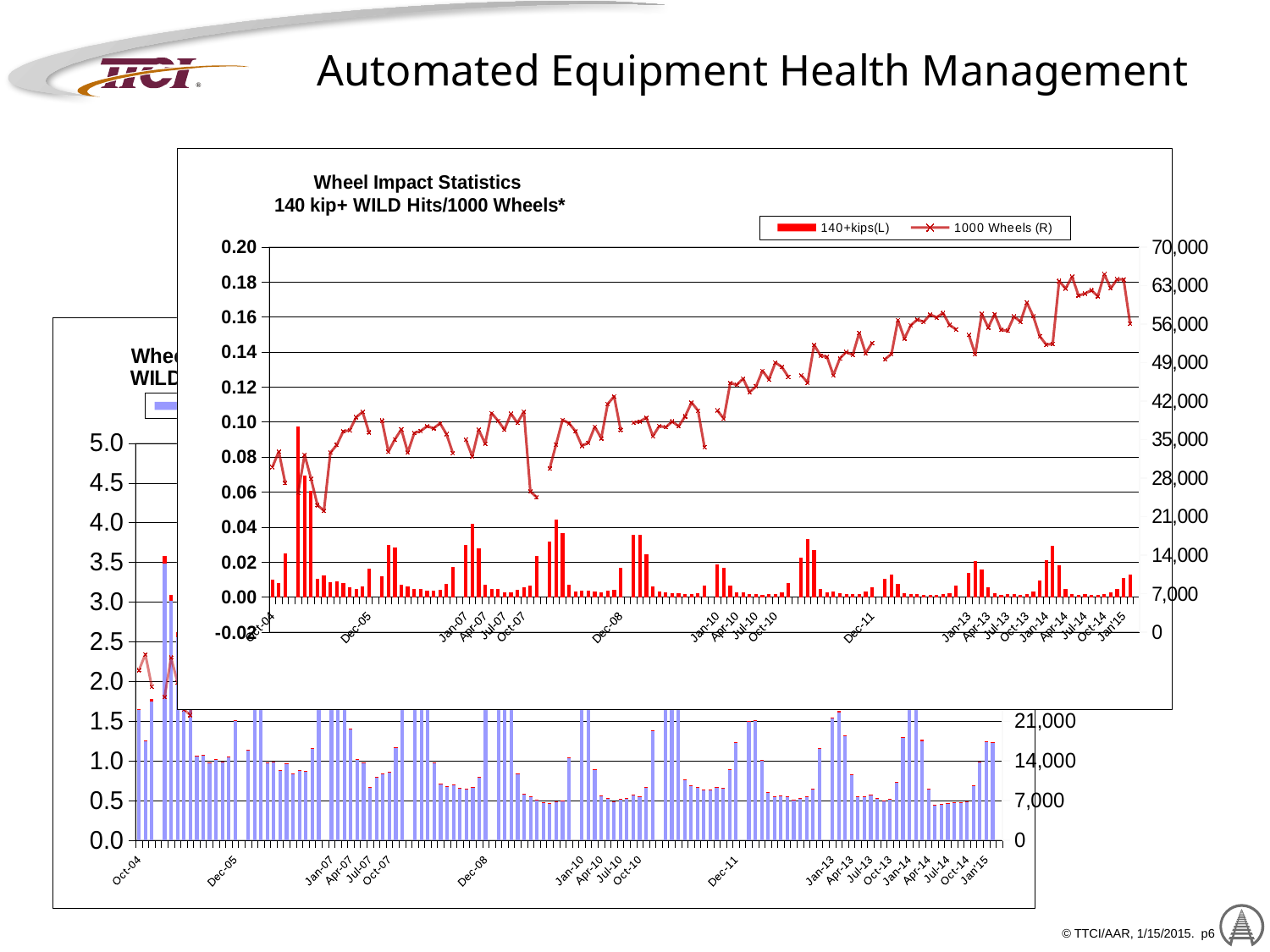
On the front chart titled 'Wheel Impact Statistics', what is the maximum value shown on the right-hand axis? 70,000 On the front chart titled 'Wheel Impact Statistics', is the '1000 Wheels (R)' value at Jan-15 greater or less than 42,000? greater On the front chart titled 'Wheel Impact Statistics', what is the second line of the chart title? 140 kip+ WILD Hits/1000 Wheels* On the front chart titled 'Wheel Impact Statistics', does the '1000 Wheels (R)' line generally rise or fall from Oct-04 to Jan-15? Rise On the chart in the lower left (behind the front chart), what is the maximum value shown on the left-hand axis? 5.0 On the front chart titled 'Wheel Impact Statistics', is the '1000 Wheels (R)' value at Dec-11 greater or less than 42,000? greater On the front chart titled 'Wheel Impact Statistics', how many series does the legend list? 2 On the chart in the lower left (behind the front chart), is the tallest blue bar greater or less than 3.0 on the left axis? greater On the front chart titled 'Wheel Impact Statistics', what kind of chart is it? A combined bar and line chart